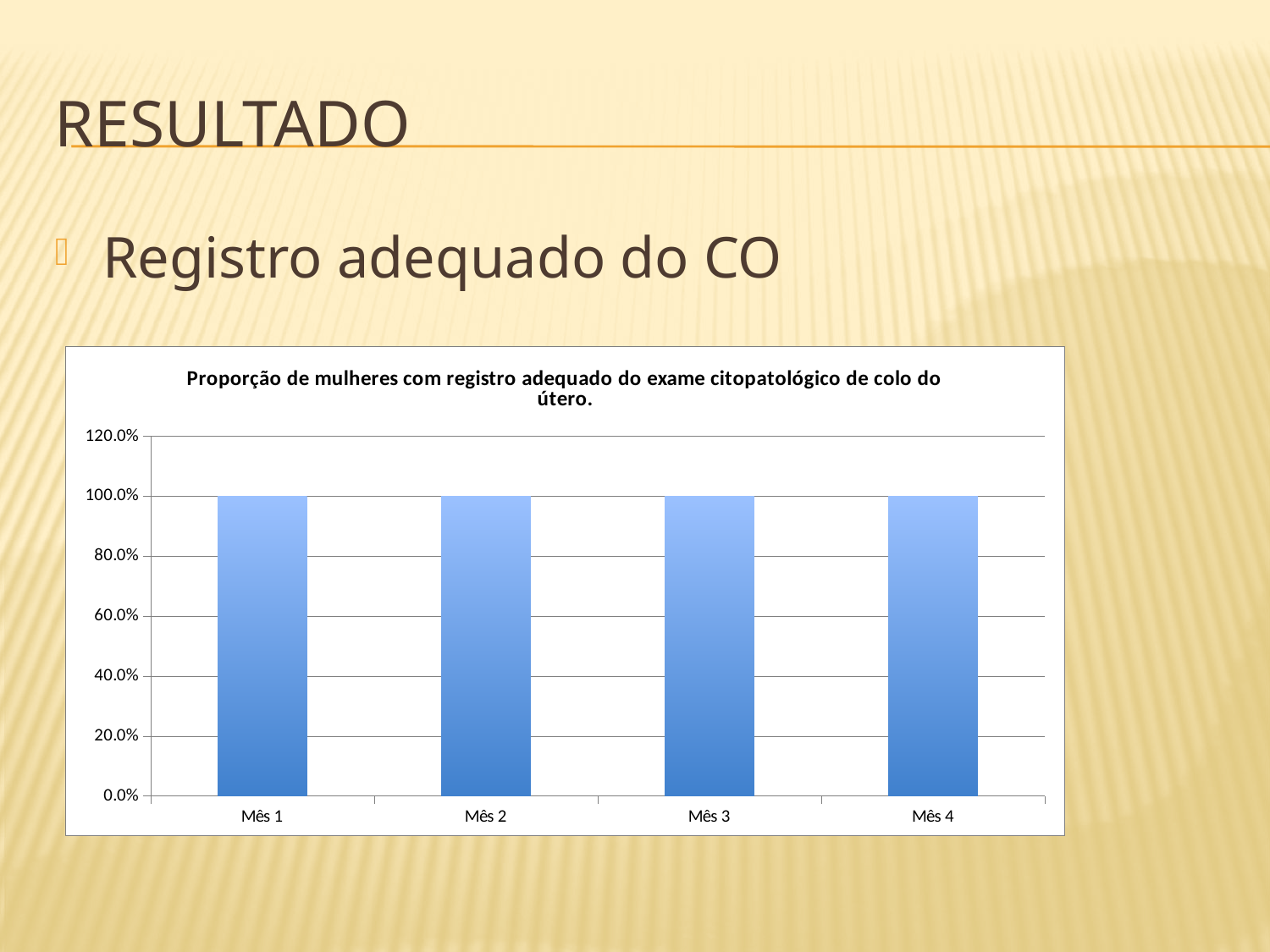
How many categories (months) are plotted on the x axis? 4 What is the value for Mês 2? 100.0% What is the difference between the values for Mês 2 and Mês 4? 0.0% Is the value for Mês 3 greater or less than 80.0%? greater What is the value for Mês 1? 100.0% What is the value for Mês 3? 100.0% What is the value for Mês 4? 100.0% Is the value for Mês 1 greater or less than 120.0%? less What is the title of the chart? Proporção de mulheres com registro adequado do exame citopatológico de colo do útero. Do the values rise, fall, or stay the same from Mês 1 to Mês 4? stay the same What kind of chart is shown on the slide? bar chart What is the highest value shown on the y axis? 120.0%